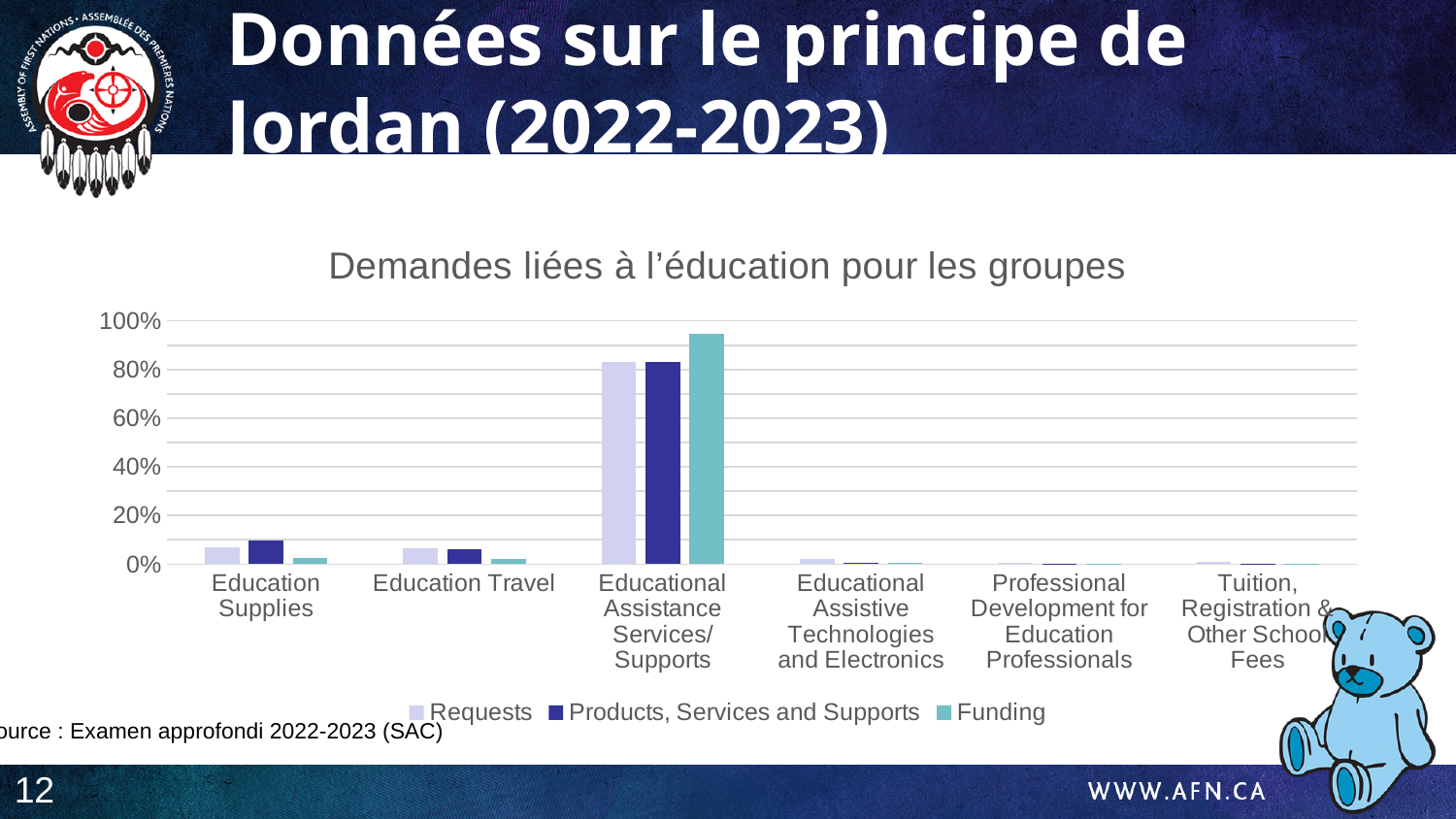
What is the title of the chart? Demandes liées à l'éducation pour les groupes Which series are listed in the chart legend? Requests; Products, Services and Supports; Funding Is the Products, Services and Supports value for Educational Assistance Services/Supports greater or less than 60%? greater Which is larger: the Requests value for Education Travel or the Requests value for Professional Development for Education Professionals? Education Travel Which is larger: the Funding value for Educational Assistance Services/Supports or the Funding value for Education Supplies? Educational Assistance Services/Supports Is the Requests value for Education Supplies greater or less than 20%? less Is the Funding value for Educational Assistance Services/Supports greater or less than 80%? greater How many series does the chart legend list? 3 What kind of chart is shown on the slide? Bar chart Which category has the highest Funding value? Educational Assistance Services/Supports How many categories are shown along the x axis of the chart? 6 Which category has the highest Requests value? Educational Assistance Services/Supports